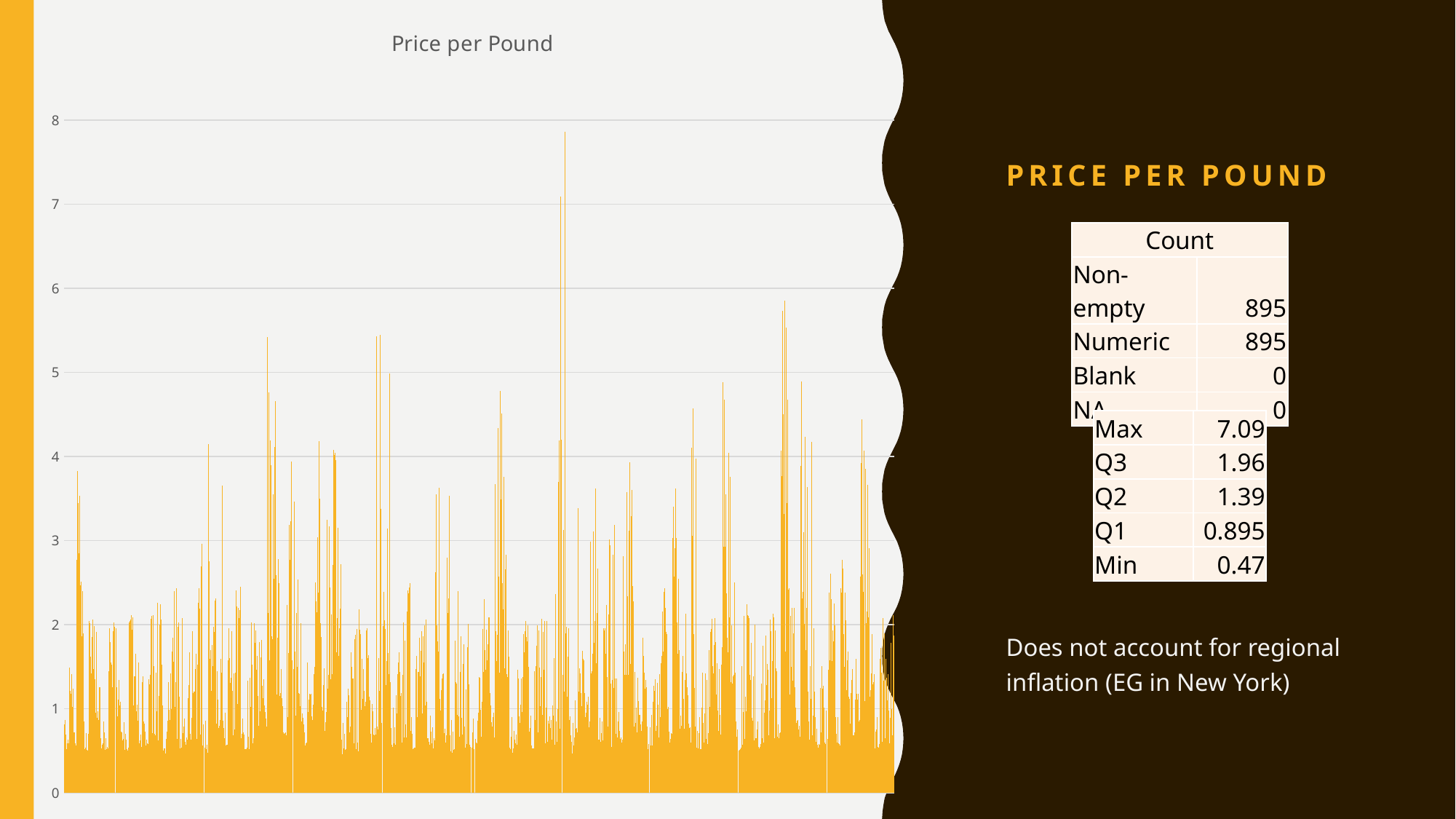
What is the lowest value labelled on the chart's vertical axis? 0 How many labelled tick values are on the chart's vertical axis? 9 What is the highest value labelled on the chart's vertical axis? 8 What is the title of the chart? Price per Pound Is the tallest bar in the chart greater or less than 8? less What kind of chart is shown on the slide? bar chart Are the majority of the bars in the chart greater or less than 4? less Is the tallest bar in the chart greater or less than 6? greater